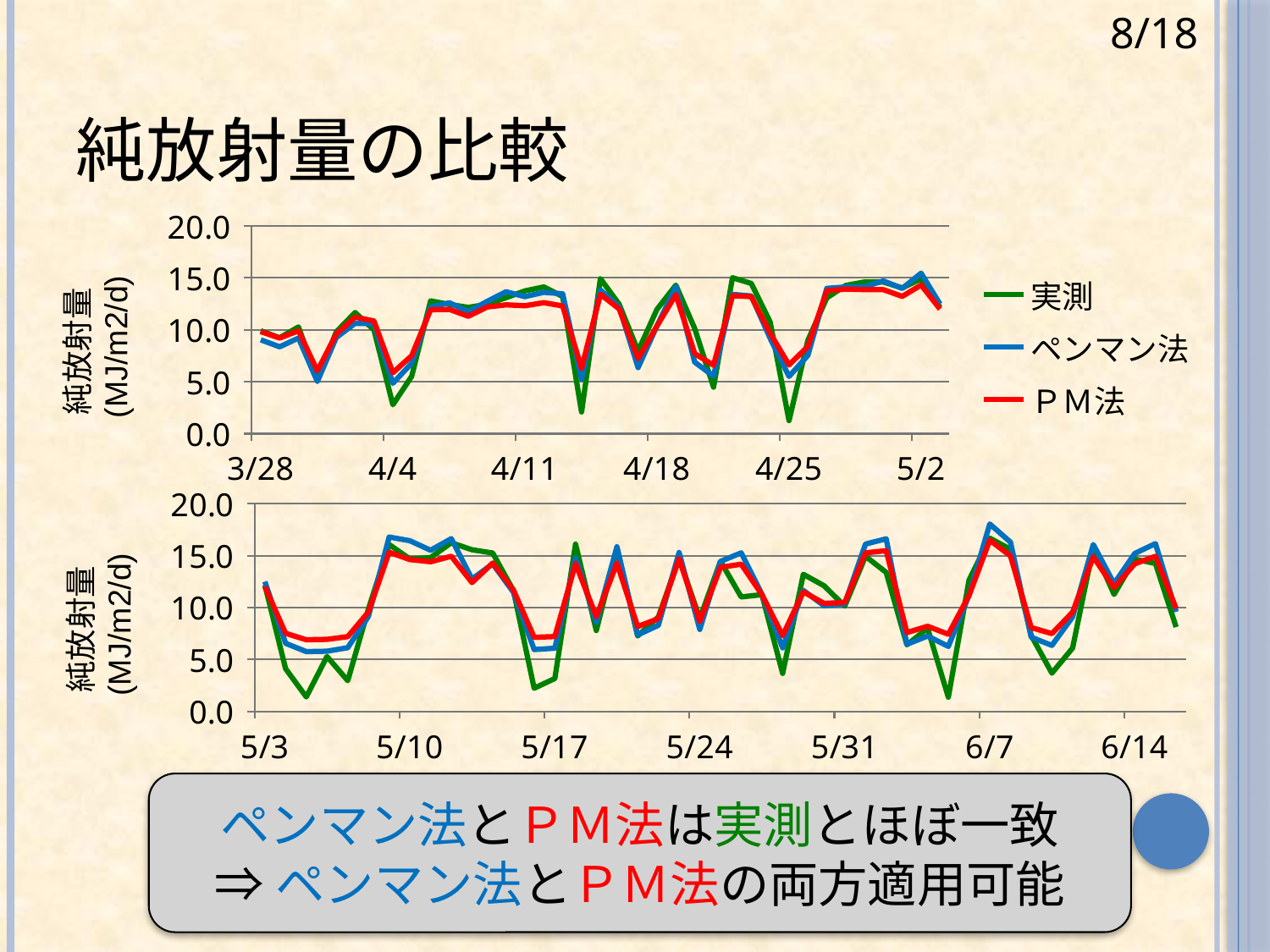
Which series is drawn in green in the legend? 実測 In the top chart (3/28–5/2), is the ペンマン法 value at 5/2 greater or less than 10.0? greater In the bottom chart (5/3–6/14), is the ペンマン法 value at 6/7 greater or less than 15.0? greater What is the title of the slide's charts? 純放射量の比較 In the bottom chart (5/3–6/14), is the 実測 value at 5/17 greater or less than 5.0? less How many date labels are shown on the x axis of the bottom chart (5/3–6/14)? 7 In the top chart (3/28–5/2), which is larger at 4/25, the 実測 value or the ＰＭ法 value? ＰＭ法 What kind of charts are shown on the slide? Line charts How many series does the legend list? 3 In the bottom chart (5/3–6/14), which is larger at 5/17, the 実測 value or the ＰＭ法 value? ＰＭ法 In the bottom chart (5/3–6/14), which series reaches the highest point on the chart? ペンマン法